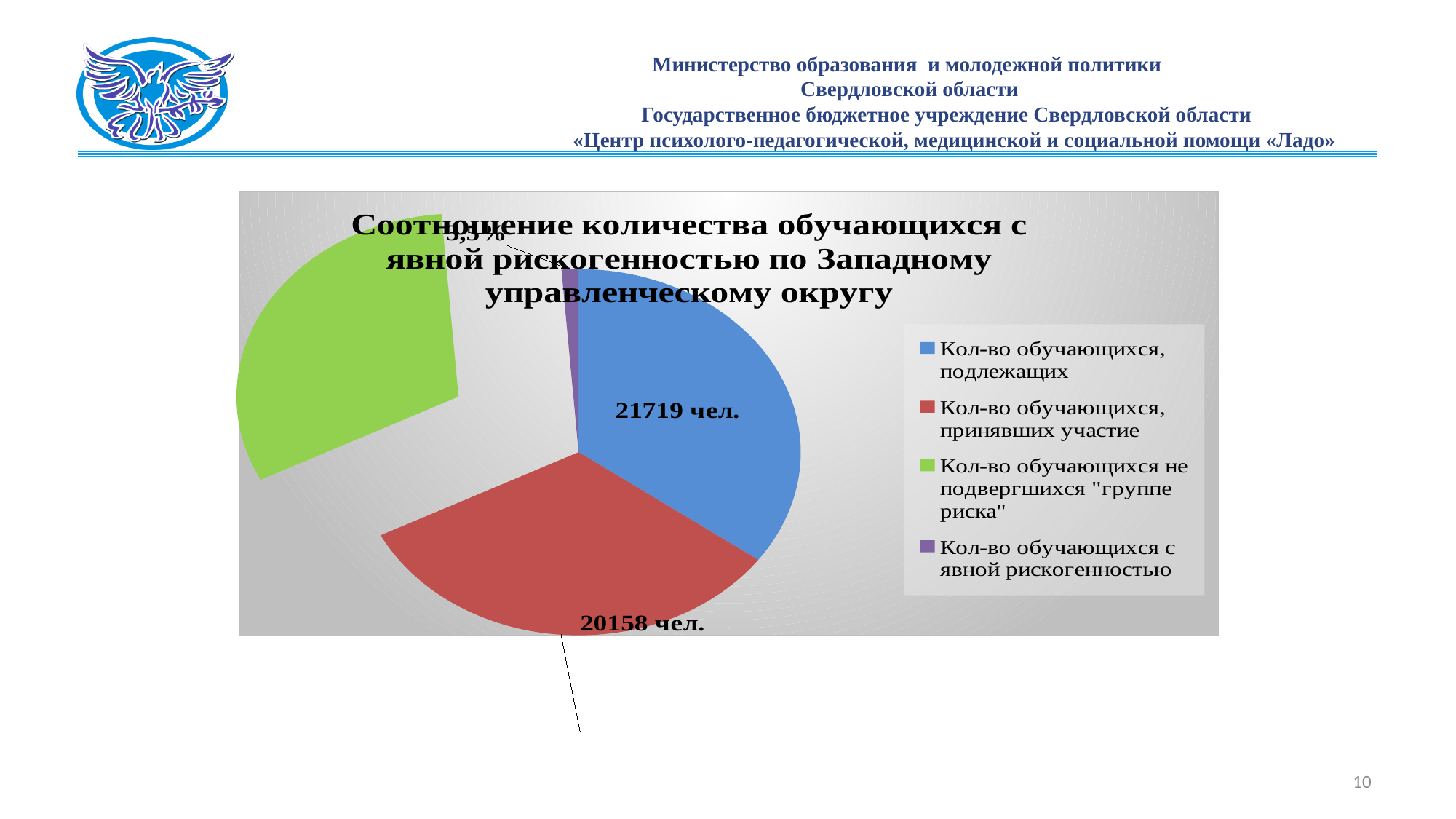
What is the title of the chart? Соотношение количества обучающихся с явной рискогенностью по Западному управленческому округу What value is labelled on the slice for "Кол-во обучающихся, принявших участие"? 20158 чел. Which is larger: "Кол-во обучающихся, подлежащих" or "Кол-во обучающихся, принявших участие"? Кол-во обучающихся, подлежащих How many entries does the chart legend list? 4 What is the difference between the number of students "подлежащих" and the number "принявших участие"? 1561 чел. How many slices does the pie chart have? 4 What value is labelled on the slice for "Кол-во обучающихся, подлежащих"? 21719 чел. Which category has the largest slice of the pie? Кол-во обучающихся, подлежащих Which category has the smallest slice of the pie? Кол-во обучающихся с явной рискогенностью Which category is shown in green in the pie chart? Кол-во обучающихся не подвергшихся "группе риска" What kind of chart is shown on the slide? Pie chart